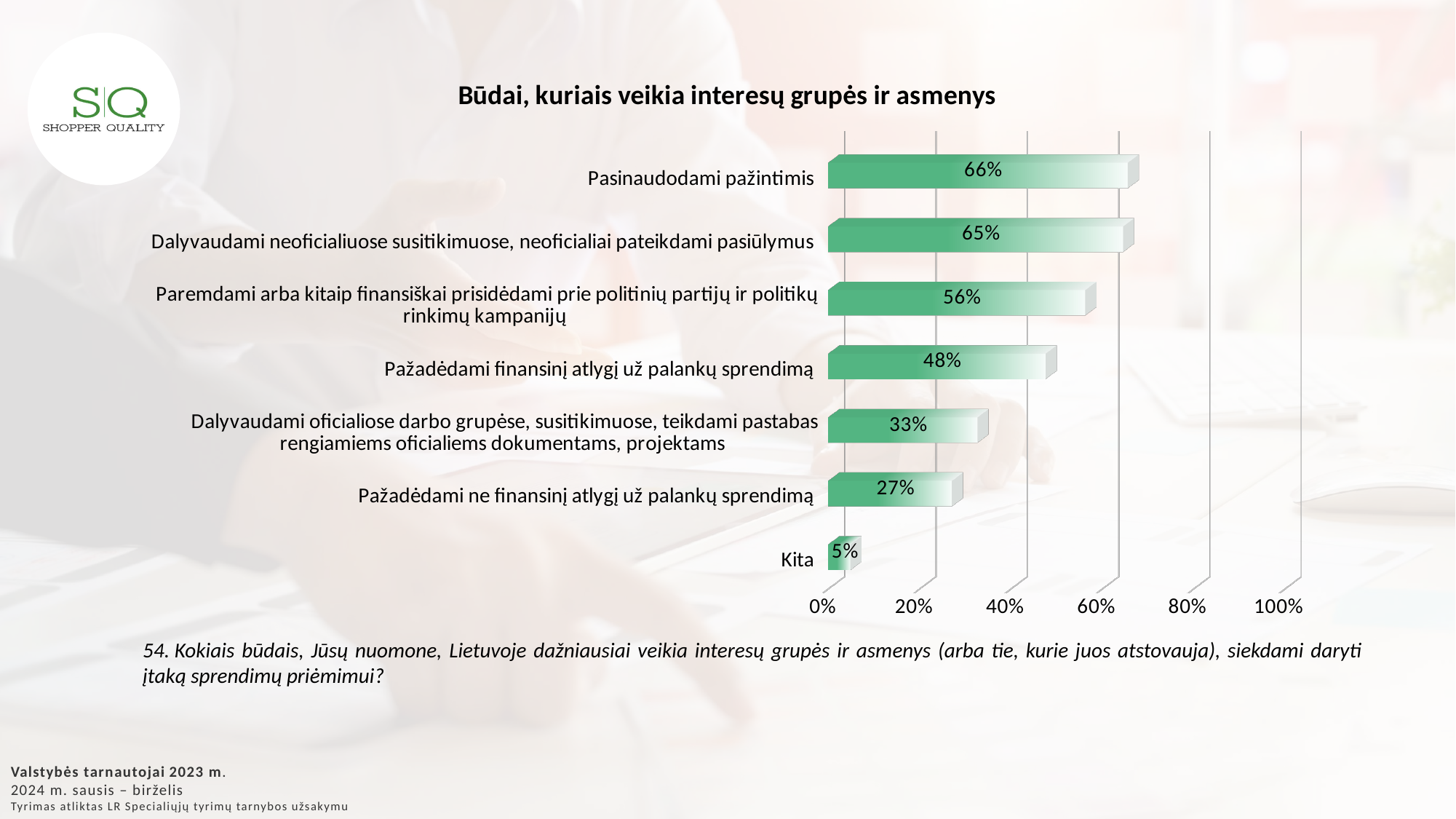
Which category has the highest value? Pasinaudodami pažintimis What kind of chart is shown on the slide? Bar chart What is the difference between the values for "Pasinaudodami pažintimis" and "Pažadėdami ne finansinį atlygį už palankų sprendimą"? 39% Is the value for "Paremdami arba kitaip finansiškai prisidėdami prie politinių partijų ir politikų rinkimų kampanijų" greater or less than 40%? greater What is the value for "Kita"? 5% How many categories are shown in the chart? 7 Which is larger: the value for "Pažadėdami finansinį atlygį už palankų sprendimą" or the value for "Dalyvaudami oficialiose darbo grupėse, susitikimuose, teikdami pastabas rengiamiems oficialiems dokumentams, projektams"? Pažadėdami finansinį atlygį už palankų sprendimą What is the highest value shown on the x axis? 100% What is the title of the chart? Būdai, kuriais veikia interesų grupės ir asmenys What is the value for "Pasinaudodami pažintimis"? 66% What is the value for "Pažadėdami finansinį atlygį už palankų sprendimą"? 48% Which category has the lowest value? Kita